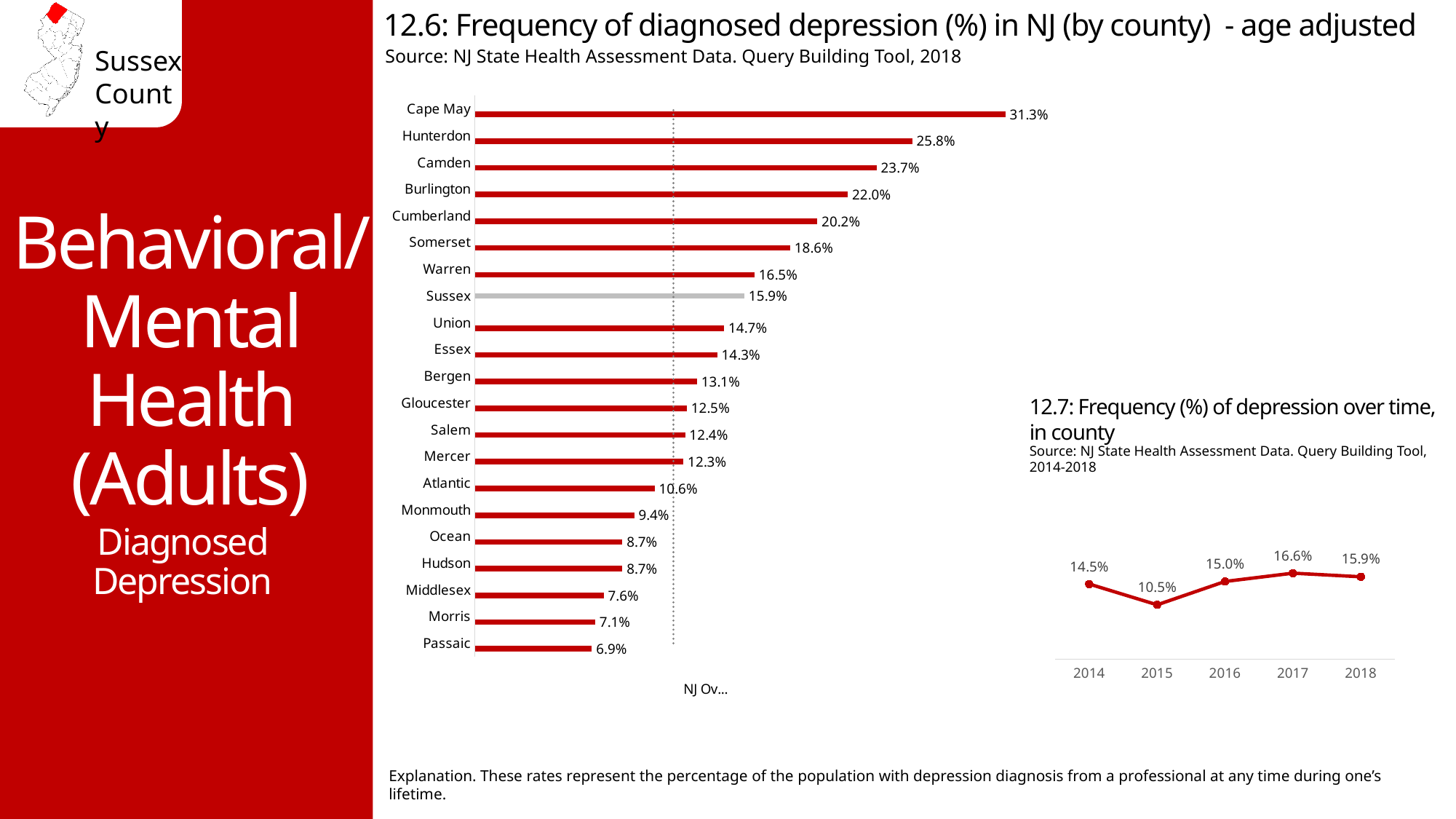
In chart 12.6 (frequency of diagnosed depression by county), which is larger, Somerset or Warren? Somerset In chart 12.7 (frequency of depression over time in county), what is the difference between 2017 and 2018? 0.7% In chart 12.6 (frequency of diagnosed depression by county), what is the value for Hunterdon? 25.8% In chart 12.7 (frequency of depression over time in county), which year has the highest value? 2017 What kind of chart is chart 12.6 (frequency of diagnosed depression by county)? Bar chart In chart 12.6 (frequency of diagnosed depression by county), which county has the highest value? Cape May In chart 12.6 (frequency of diagnosed depression by county), how many counties are plotted? 21 What kind of chart is chart 12.7 (frequency of depression over time in county)? Line chart In chart 12.6 (frequency of diagnosed depression by county), what is the value for Sussex? 15.9% In chart 12.6 (frequency of diagnosed depression by county), what is the difference between Cape May and Passaic? 24.4% In chart 12.6 (frequency of diagnosed depression by county), which county has the lowest value? Passaic In chart 12.7 (frequency of depression over time in county), what is the value for 2015? 10.5%